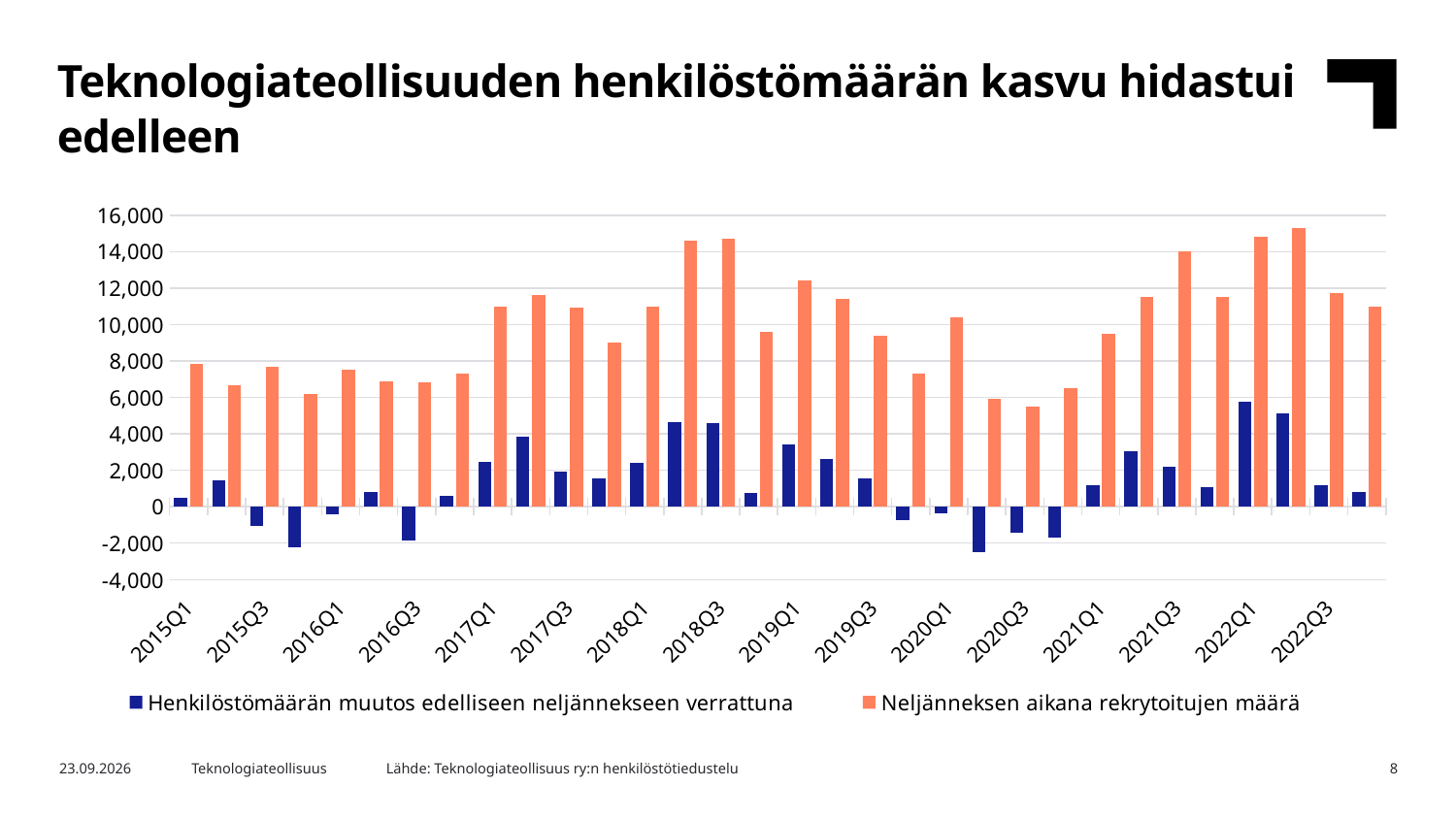
What kind of chart is shown on the slide? Bar chart Which is larger, the Neljänneksen aikana rekrytoitujen määrä value for 2018Q3 or for 2015Q1? 2018Q3 Is the value of Neljänneksen aikana rekrytoitujen määrä for 2015Q1 greater or less than 6,000? greater Which series is drawn in orange? Neljänneksen aikana rekrytoitujen määrä Is the value of Neljänneksen aikana rekrytoitujen määrä for 2018Q3 greater or less than 14,000? greater Do the Neljänneksen aikana rekrytoitujen määrä values rise or fall from 2020Q3 to 2021Q3? rise Which series is drawn in dark blue? Henkilöstömäärän muutos edelliseen neljännekseen verrattuna How many series does the legend list? 2 Is the value of Henkilöstömäärän muutos edelliseen neljännekseen verrattuna for 2022Q1 greater or less than 4,000? greater Which is larger, the Henkilöstömäärän muutos edelliseen neljännekseen verrattuna value for 2022Q1 or for 2015Q1? 2022Q1